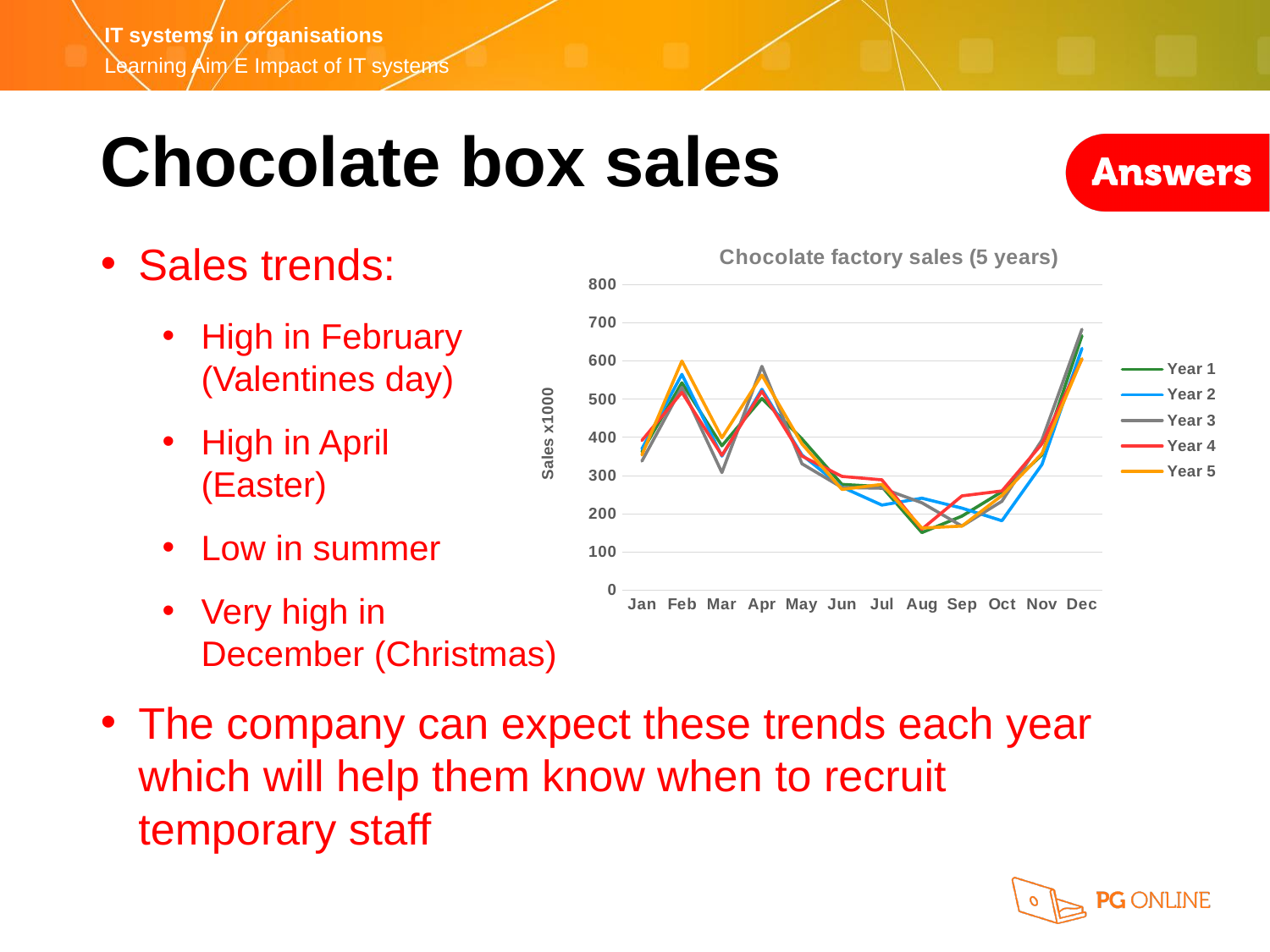
Which series has the highest value in Feb? Year 5 What kind of chart is shown on the slide? line chart Which series has the highest value in Dec? Year 3 What is the title of the chart? Chocolate factory sales (5 years) Is the value for Year 5 in Feb greater or less than 500? greater What is the label on the vertical axis of the chart? Sales x1000 Is the value for Year 1 in Aug greater or less than 200? less How many months are shown along the x axis of the chart? 12 Do the values for Year 1 rise or fall from Sep to Dec? rise Is the value for Year 3 in Dec greater or less than 600? greater How many series does the legend of the chart list? 5